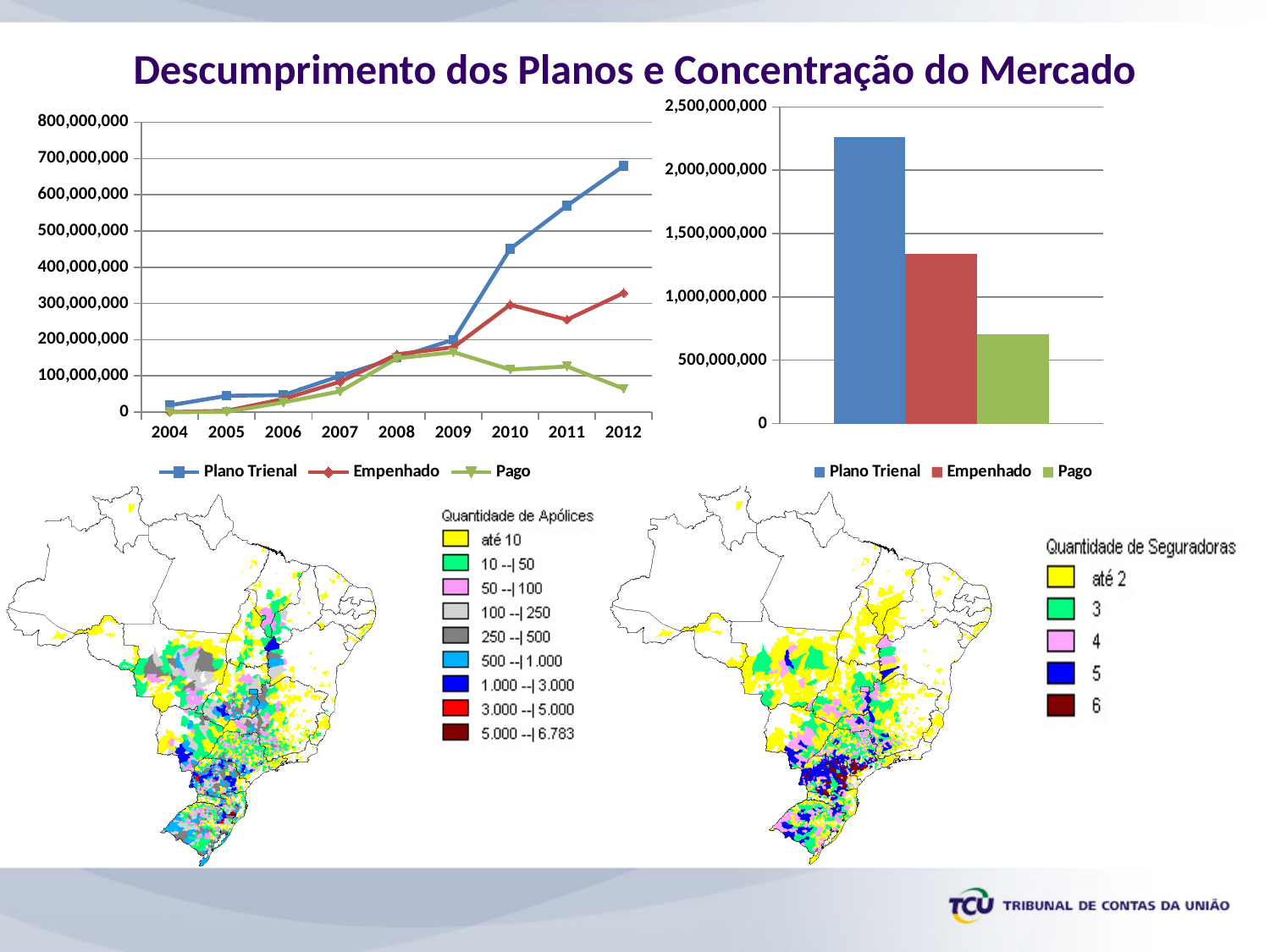
In the line chart on the left, does the Plano Trienal series rise or fall from 2004 to 2012? rise In the line chart on the left, how many series does the legend list? 3 In the line chart on the left, which series has the highest value in 2012? Plano Trienal In the line chart on the left, is the value of Plano Trienal in 2012 greater or less than 600,000,000? greater What kind of chart is the chart on the left of the slide, with years 2004 to 2012 on the x axis? line chart In the line chart on the left, how many years are shown on the x axis? 9 In the line chart on the left, is the value of Pago in 2012 greater or less than 100,000,000? less In the bar chart on the right, is the value for Plano Trienal greater or less than 2,000,000,000? greater In the bar chart on the right, which is larger, Empenhado or Pago? Empenhado What kind of chart is the chart on the right of the slide, with the 2,500,000,000 axis? bar chart In the line chart on the left, which series has the lowest value in 2012? Pago In the bar chart on the right, which series has the tallest bar? Plano Trienal